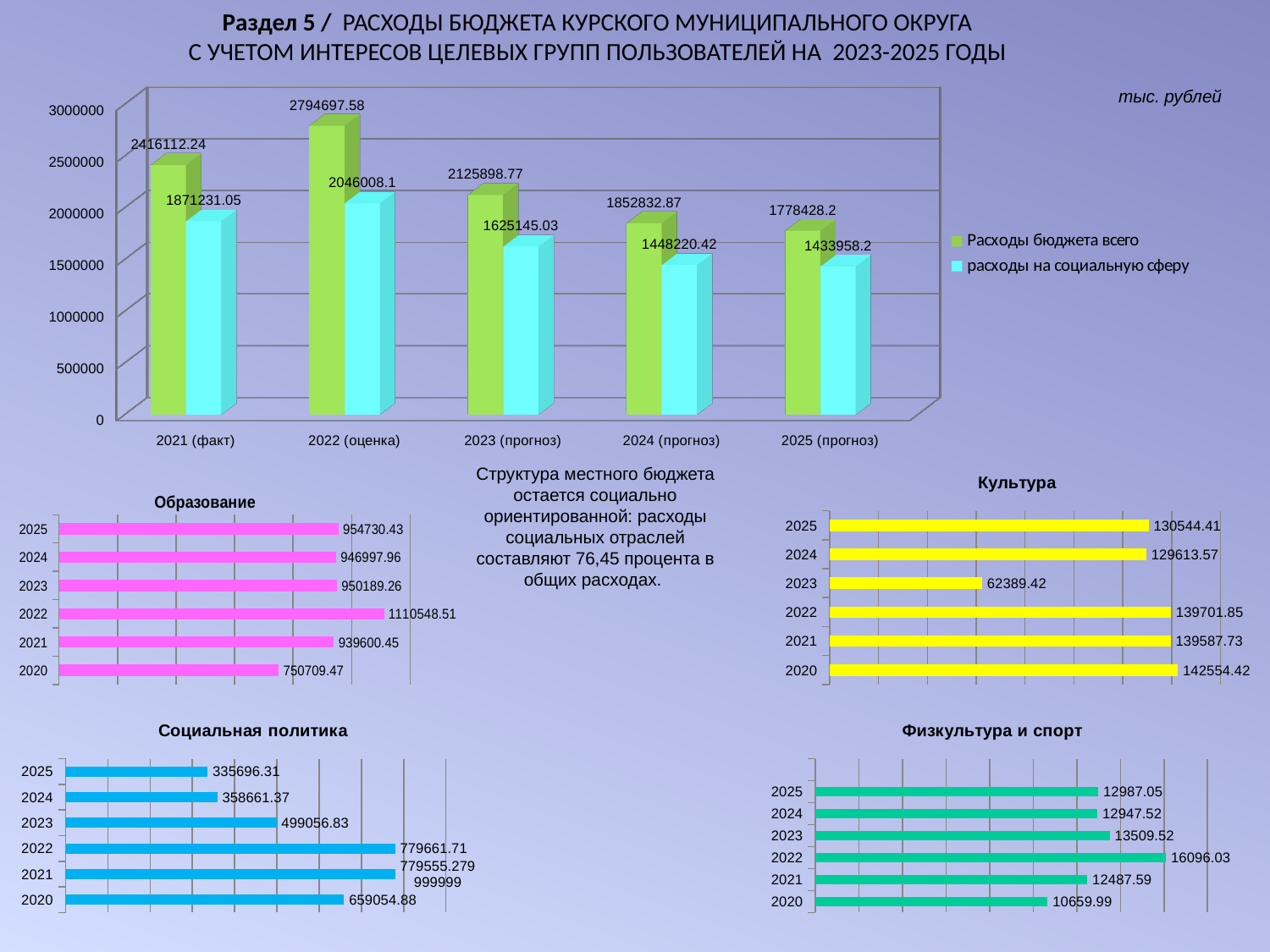
On the top chart, in which year is 'Расходы бюджета всего' the highest? 2022 (оценка) On the 'Образование' chart, which year has the lowest value? 2020 On the top chart, what is the value of 'Расходы бюджета всего' for 2022 (оценка)? 2794697.58 On the 'Физкультура и спорт' chart, how many years are shown? 6 On the 'Физкультура и спорт' chart, which year has the highest value? 2022 On the 'Культура' chart, which year has the lowest value? 2023 On the top chart, how many series does the legend list? 2 On the top chart, what is the value of 'расходы на социальную сферу' for 2024 (прогноз)? 1448220.42 On the 'Образование' chart, what is the value for 2022? 1110548.51 On the 'Социальная политика' chart, what is the value for 2023? 499056.83 On the top chart, what is the difference between 'Расходы бюджета всего' and 'расходы на социальную сферу' for 2021 (факт)? 544881.19 On the 'Культура' chart, what is the value for 2020? 142554.42